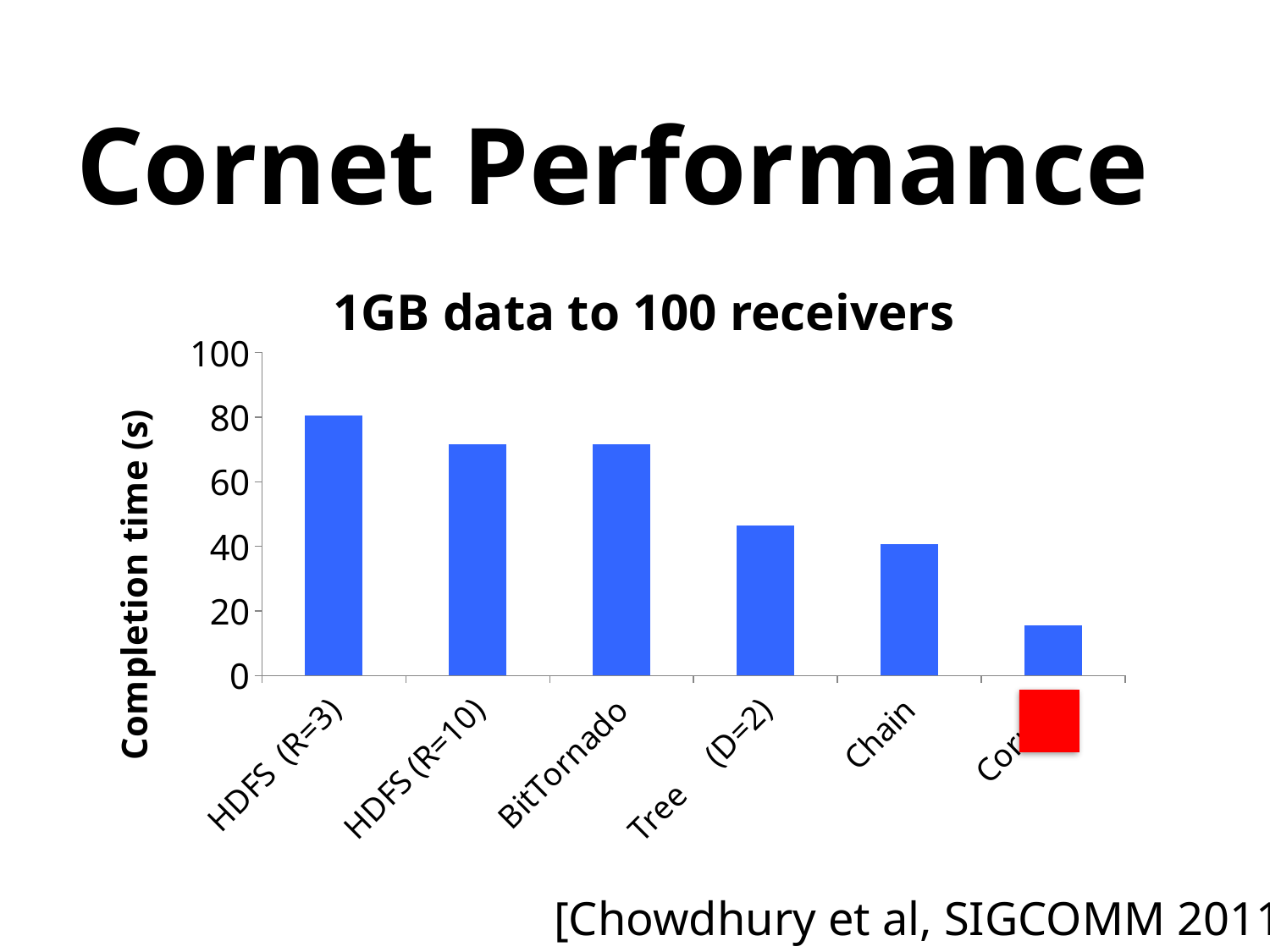
Which category has the highest completion time? HDFS (R=3) Which has a higher completion time, HDFS (R=3) or Tree (D=2)? HDFS (R=3) What is the title of the chart? 1GB data to 100 receivers Is the completion time for Chain greater or less than 60? less Is the completion time for Tree (D=2) greater or less than 60? less What kind of chart is shown on the slide? bar chart How many bars are plotted in the chart? 6 What is the label of the vertical axis? Completion time (s) Do the completion times generally rise or fall moving from left to right across the categories? fall Is the completion time for BitTornado greater or less than 80? less Which has a higher completion time, Tree (D=2) or Chain? Tree (D=2)